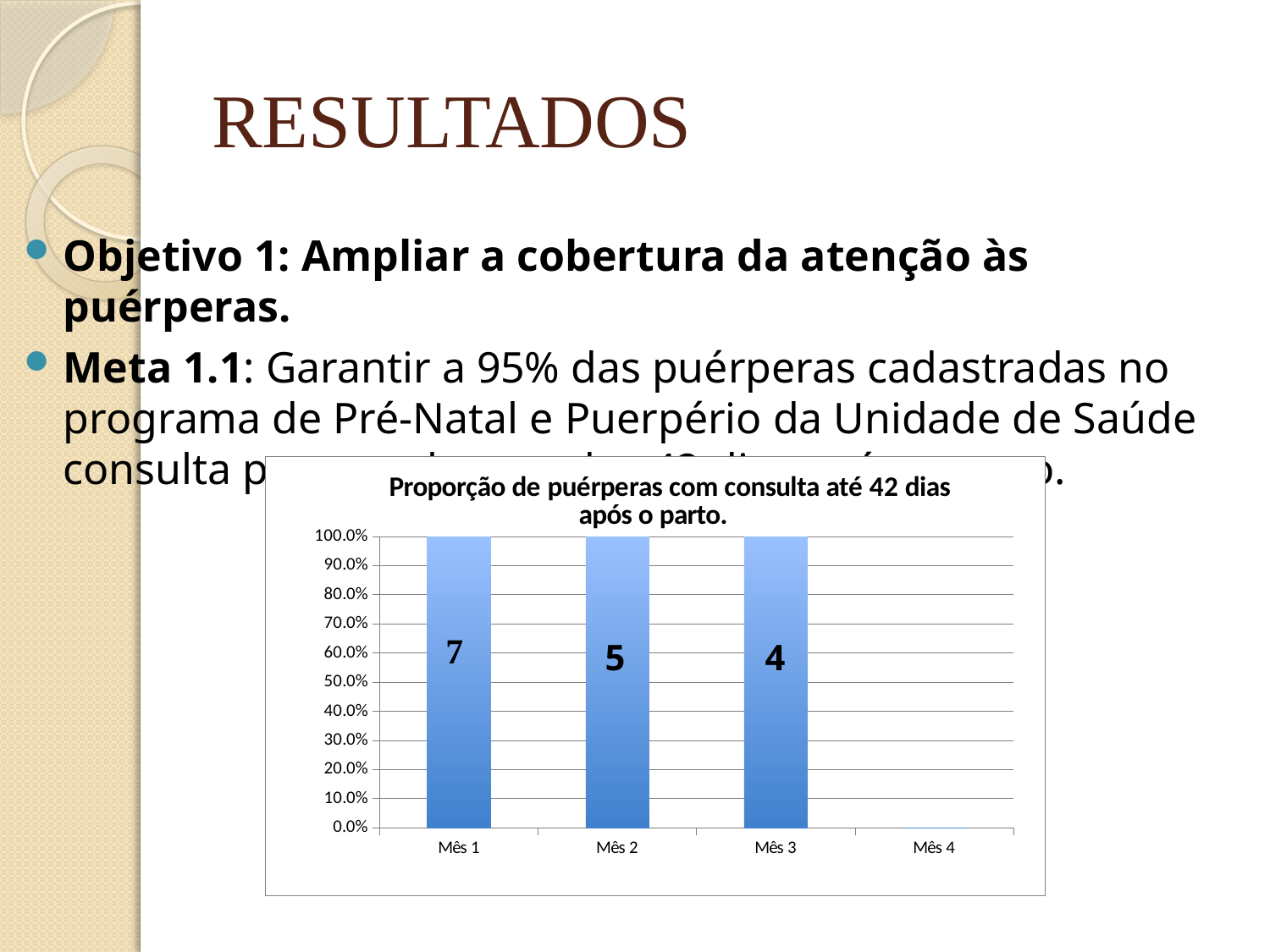
Which bar has the larger printed number, Mês 1 or Mês 3? Mês 1 What number is printed on the bar for Mês 2? 5 Is the value for Mês 2 greater or less than 90.0%? greater What percentage does the bar for Mês 1 reach on the y axis? 100.0% Which month has the lowest value in the chart? Mês 4 What percentage does the bar for Mês 3 reach on the y axis? 100.0% What number is printed on the bar for Mês 1? 7 What is the title of the chart? Proporção de puérperas com consulta até 42 dias após o parto. What is the difference between the numbers printed on the bars for Mês 1 and Mês 2? 2 What kind of chart is shown on the slide? bar chart What number is printed on the bar for Mês 3? 4 How many months (categories) are shown on the x axis of the chart? 4